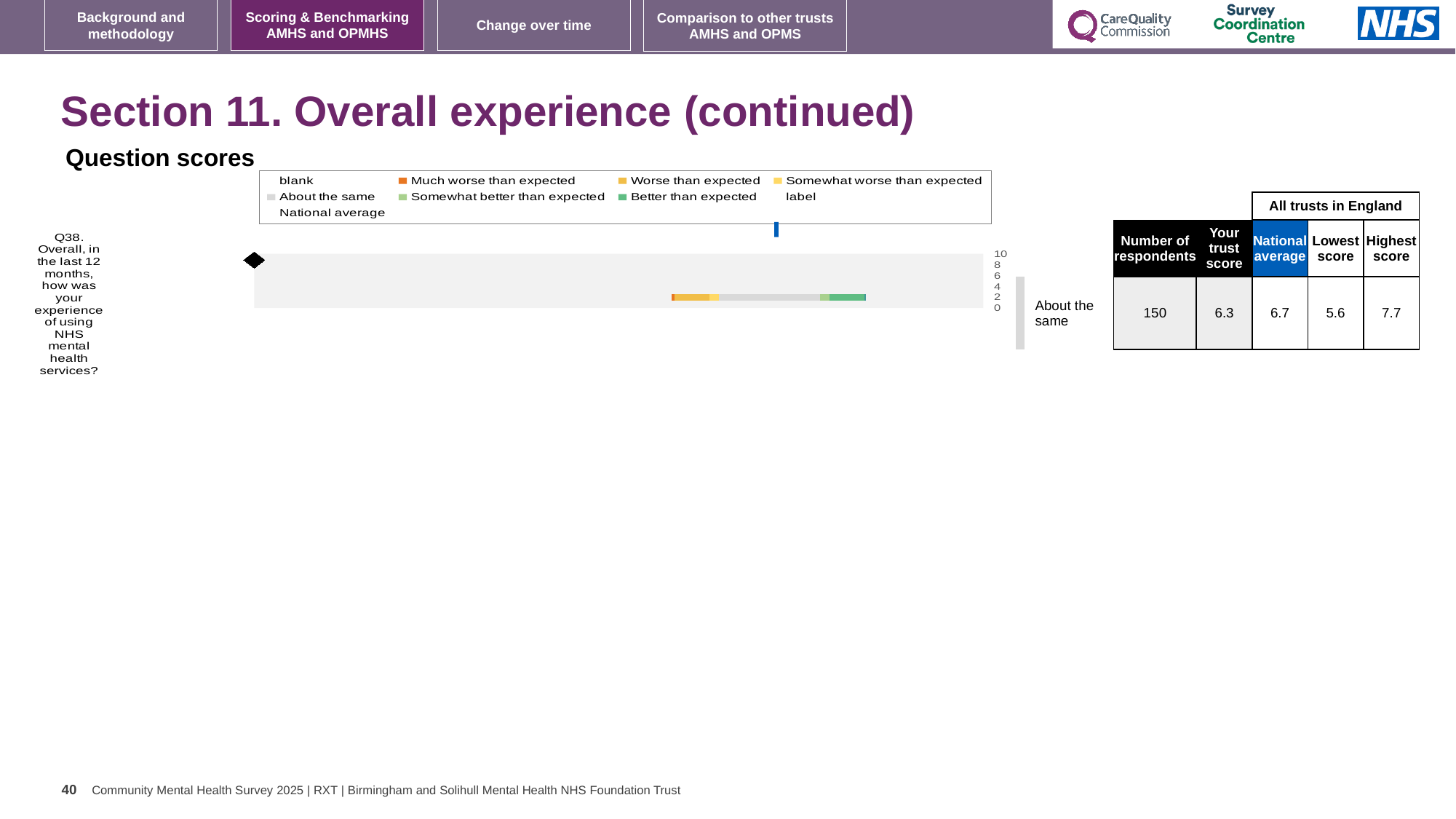
What is the difference between the national average and the trust score for Q38? 0.4 How many questions (categories) are plotted in the Question scores chart? 1 How many respondents answered Q38? 150 What is the national average for Q38 shown next to the Question scores chart? 6.7 Which legend entry in the Question scores chart is shown in orange? Much worse than expected What kind of chart is shown under 'Question scores'? bar chart What is the lowest score among all trusts in England for Q38? 5.6 How is the trust's Q38 result categorised relative to other trusts? About the same Which is larger for Q38, the trust score or the national average? national average Which question is plotted in the Question scores chart? Q38. Overall, in the last 12 months, how was your experience of using NHS mental health services? What is the trust score for Q38 shown next to the Question scores chart? 6.3 What is the highest score among all trusts in England for Q38? 7.7